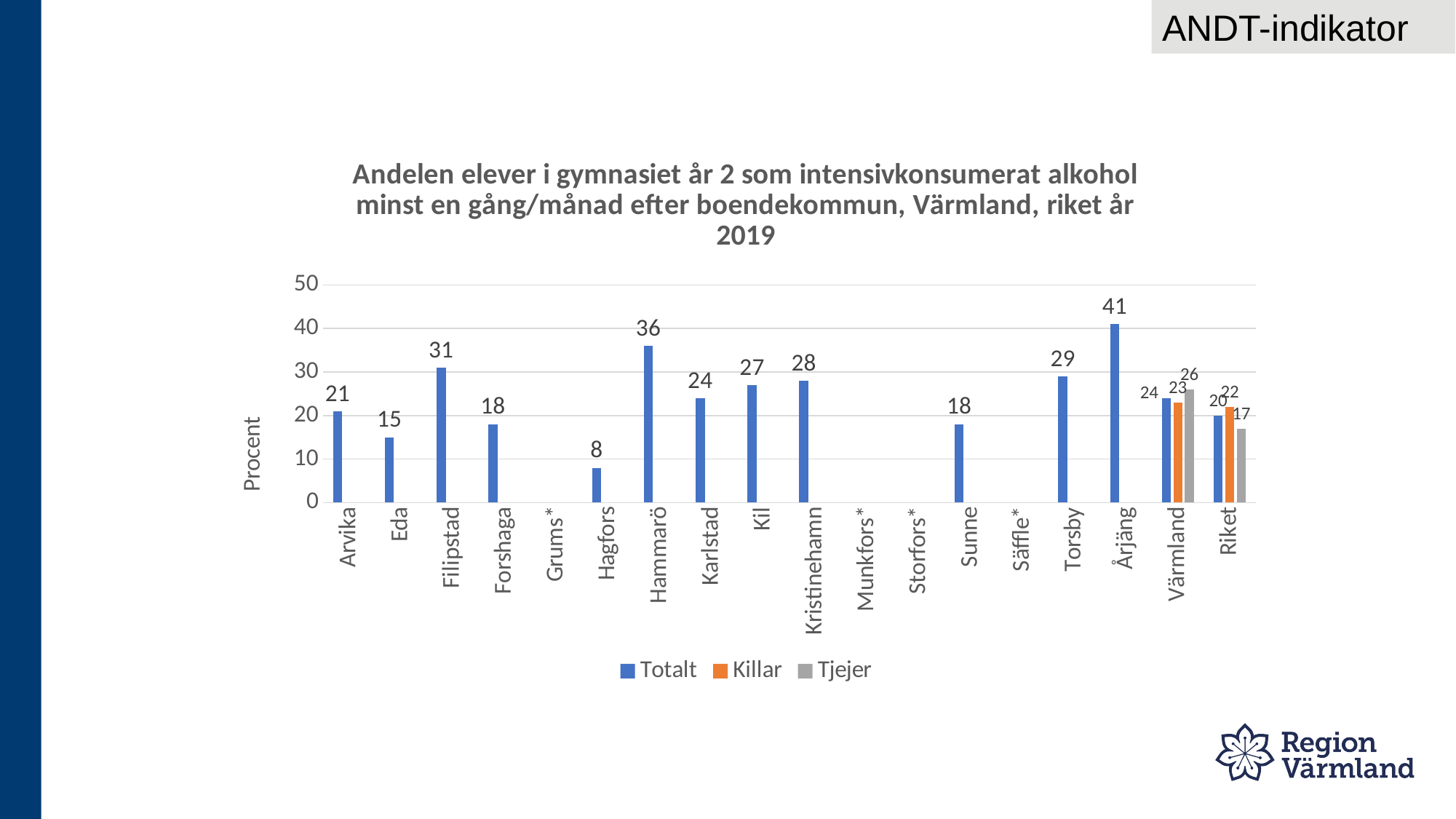
How many categories are shown on the x axis? 18 Which municipality with a plotted bar has the lowest Totalt value? Hagfors What is the difference between the Totalt values for Filipstad and Eda? 16 What kind of chart is shown on the slide? Bar chart Which has a higher Totalt value, Kil or Karlstad? Kil Is the Totalt value for Torsby greater or less than 20? greater What is the Tjejer value for Värmland? 26 What is the Killar value for Riket? 22 What is the label of the y axis? Procent How many series does the legend list? 3 What is the Totalt value for Hammarö? 36 Which municipality has the highest Totalt value? Årjäng